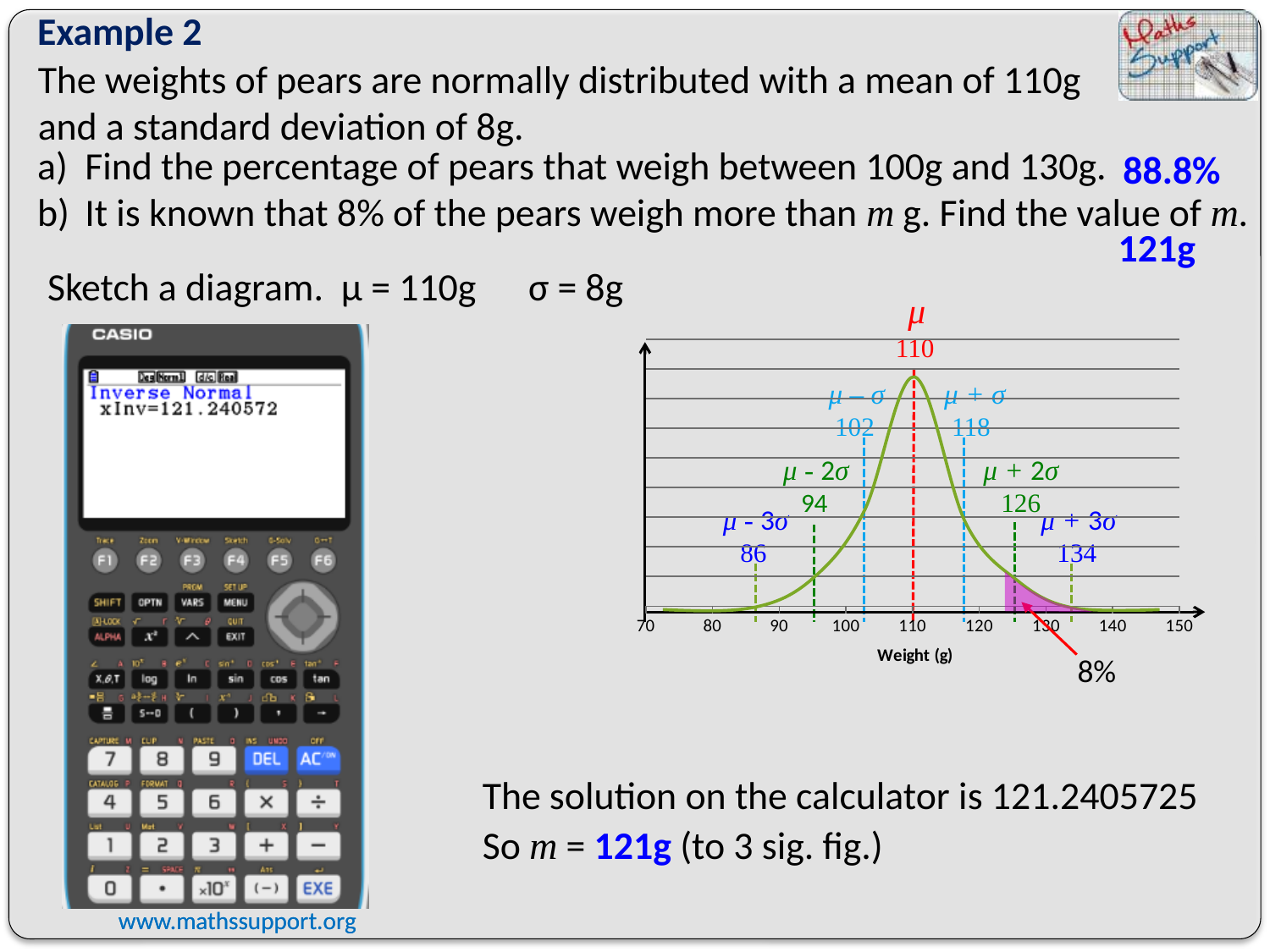
What weight value is marked at μ + 3σ on the sketch? 134 What weight value is marked at μ + σ on the sketch? 118 What weight value is marked at μ + 2σ on the sketch? 126 What is the highest tick value shown on the x-axis of the sketch? 150 What is the difference between the values marked at μ + σ and μ − σ on the sketch? 16 What weight value is marked at μ on the sketch? 110 Does the curve rise or fall as the weight increases from 110 to 150? fall How many vertical dashed lines mark μ and its standard deviation positions on the sketch? 7 What weight value is marked at μ − σ on the sketch? 102 What is the label on the x-axis of the normal distribution sketch? Weight (g) What weight value is marked at μ − 3σ on the sketch? 86 What percentage is the shaded region under the right tail of the curve labelled with? 8%